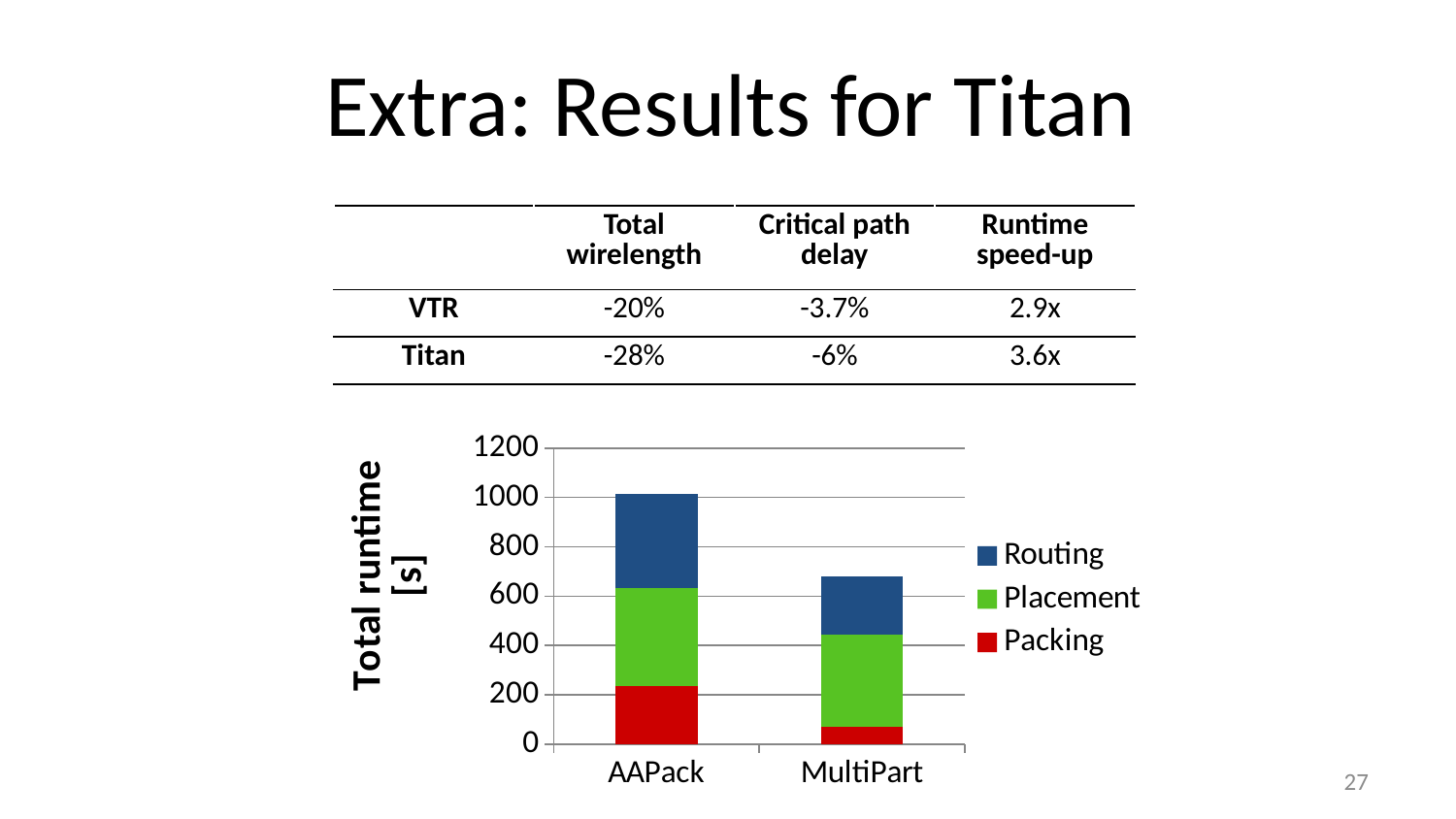
Is the Packing runtime for MultiPart greater or less than 200? less Which category has the lower total runtime? MultiPart Is the total runtime for AAPack greater or less than 800? greater Which colour represents the Routing series in the chart? blue Which category has the larger Packing runtime, AAPack or MultiPart? AAPack How many categories are shown on the x axis of the chart? 2 Is the total runtime for MultiPart greater or less than 800? less Which category has the higher total runtime, AAPack or MultiPart? AAPack What kind of chart is shown on the slide? bar chart What is the title of the chart's vertical axis? Total runtime [s] How many series does the chart's legend list? 3